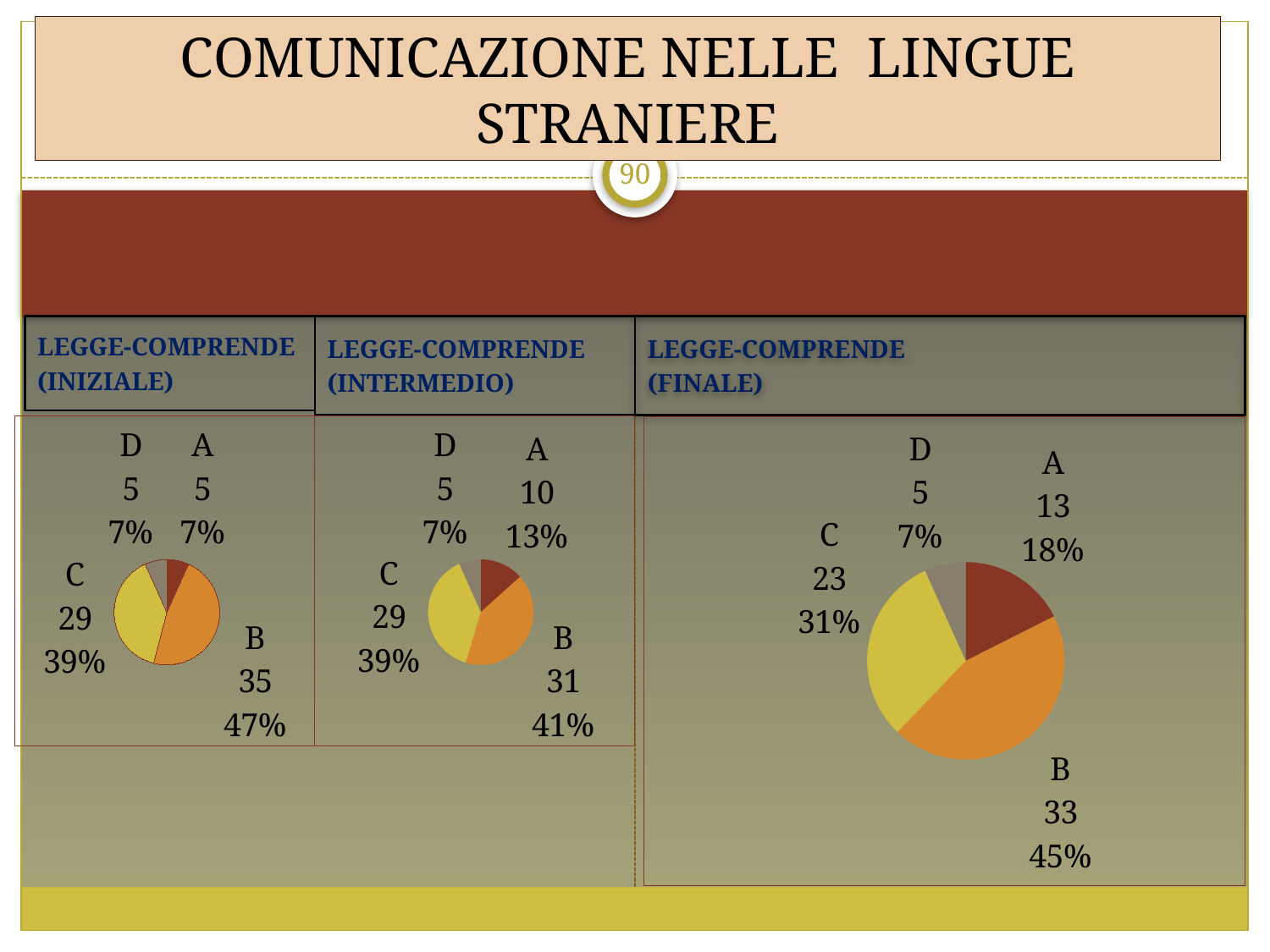
In the LEGGE-COMPRENDE (INTERMEDIO) chart, what is the value for A? 10 What type of chart is used for LEGGE-COMPRENDE (INIZIALE)? Pie chart In the LEGGE-COMPRENDE (INIZIALE) chart, what is the value for B? 35 In the LEGGE-COMPRENDE (INIZIALE) chart, which category has the largest slice? B In the LEGGE-COMPRENDE (FINALE) chart, what share of the pie does A represent? 18% In the LEGGE-COMPRENDE (INTERMEDIO) chart, what is the difference between the values for B and C? 2 How many categories are shown in the LEGGE-COMPRENDE (FINALE) chart? 4 In the LEGGE-COMPRENDE (FINALE) chart, which is larger, the value for B or the value for C? B In the LEGGE-COMPRENDE (FINALE) chart, what is the value for C? 23 In the LEGGE-COMPRENDE (FINALE) chart, which category has the smallest slice? D In the LEGGE-COMPRENDE (INIZIALE) chart, what share of the pie does C represent? 39% In the LEGGE-COMPRENDE (INTERMEDIO) chart, what percentage is shown for B? 41%